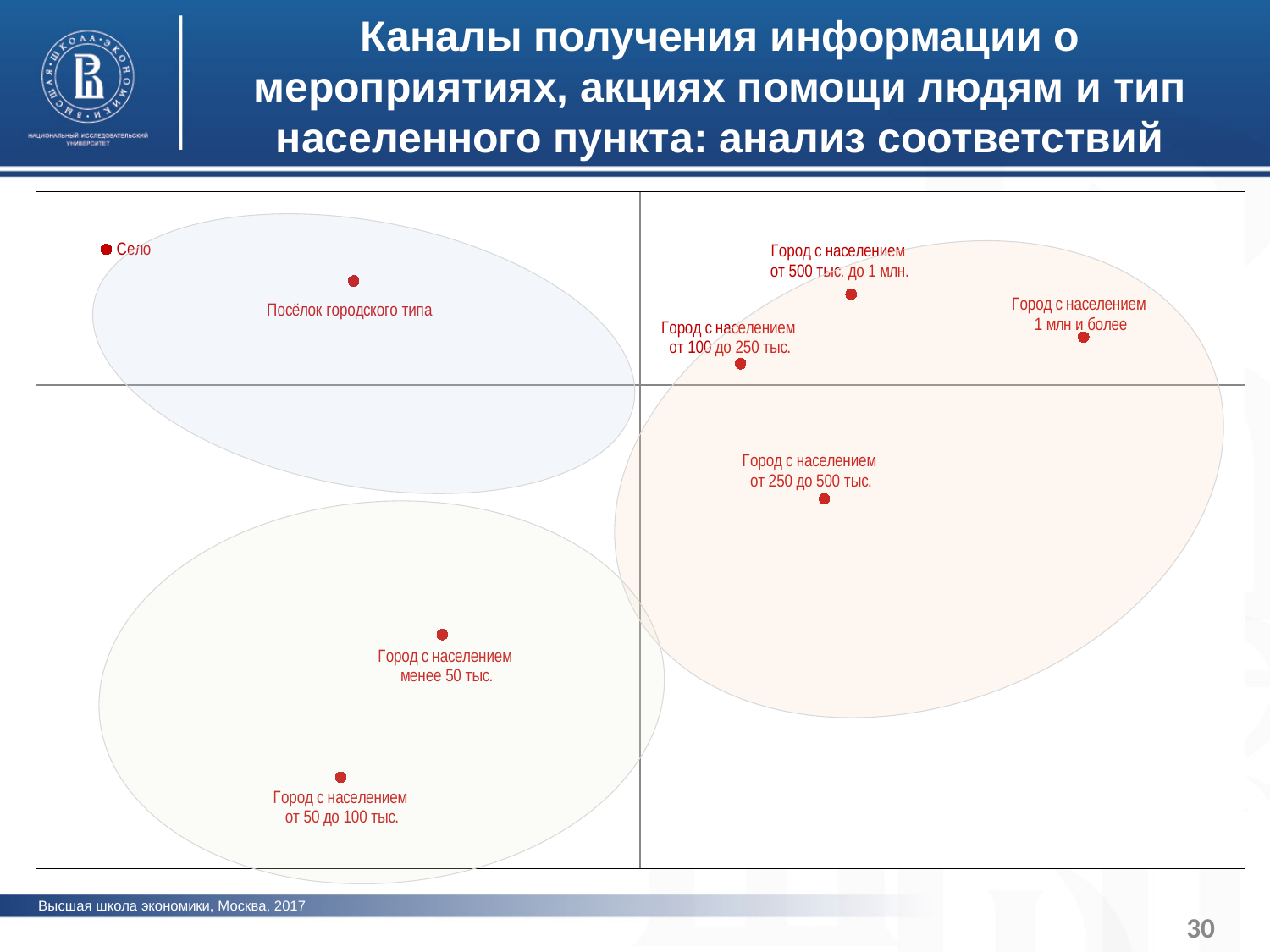
How many labelled data points are plotted on the chart? 8 How many shaded ellipses (groupings) are drawn on the chart? 3 Which two settlement types are grouped together in the lower-left ellipse? Город с населением менее 50 тыс. and Город с населением от 50 до 100 тыс. Is the point for Город с населением от 250 до 500 тыс. in the left or right half of the chart? right How many settlement types are grouped in the right-hand ellipse? 4 Which is plotted higher on the chart: Село or Город с населением менее 50 тыс.? Село Which settlement type is plotted in the upper-left corner of the chart? Село What kind of chart is shown on the slide? scatter chart Which settlement type is plotted lowest on the chart? Город с населением от 50 до 100 тыс. Which settlement type is plotted furthest to the right on the chart? Город с населением 1 млн и более